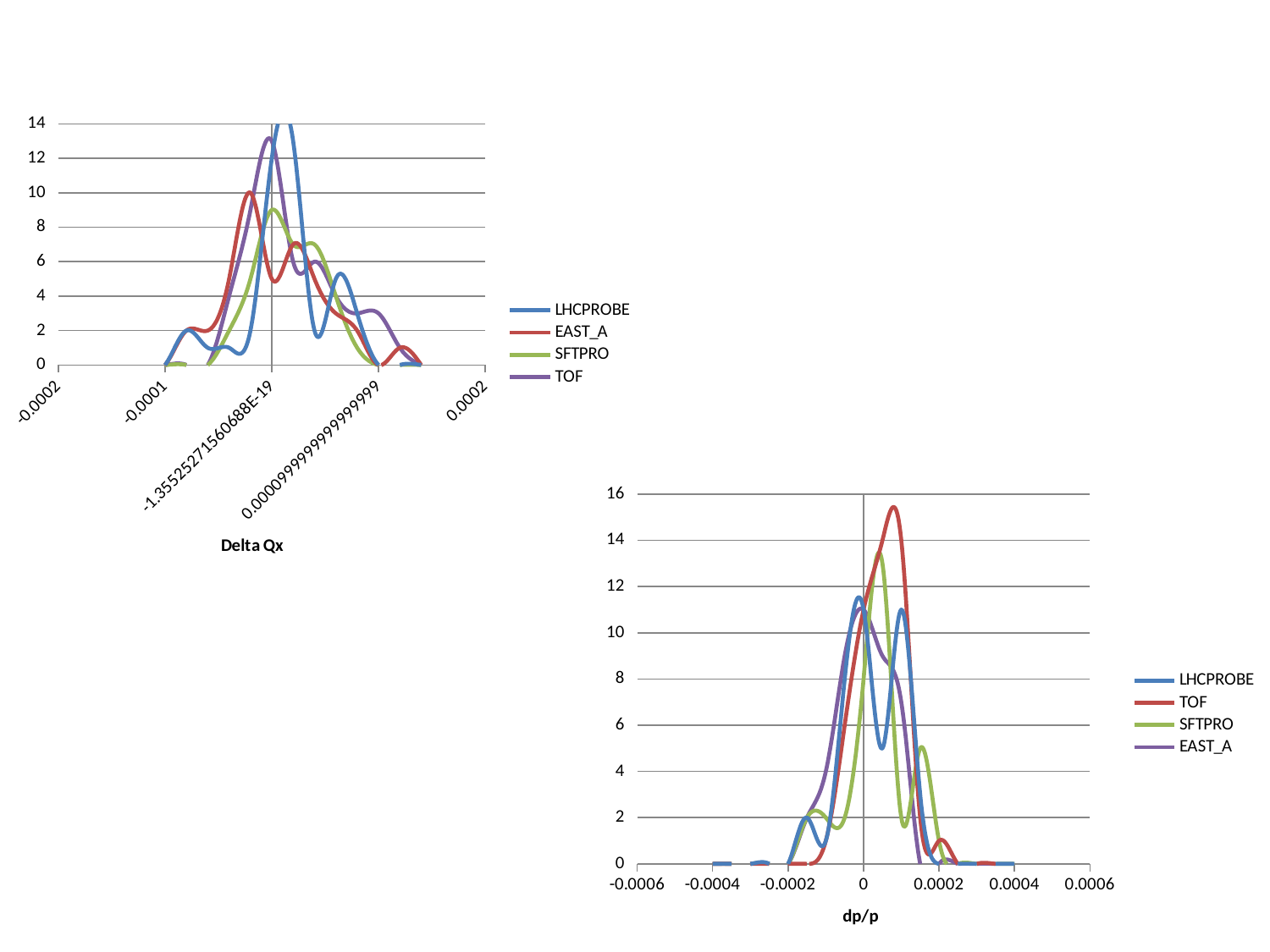
In the dp/p chart, which series reaches the highest peak? TOF In the Delta Qx chart, which series reaches the highest peak? LHCPROBE What kind of chart is the chart with the x-axis labelled Delta Qx? line chart What is the x-axis label of the chart on the lower right of the slide? dp/p In the dp/p chart, which series is listed second in the legend? TOF How many series does the legend of the Delta Qx chart list? 4 In the dp/p chart, is the peak value of EAST_A greater or less than 12? less In the dp/p chart, is the peak value of SFTPRO greater or less than 12? greater How many series does the legend of the dp/p chart list? 4 In the Delta Qx chart, is the peak value of TOF greater or less than 12? greater